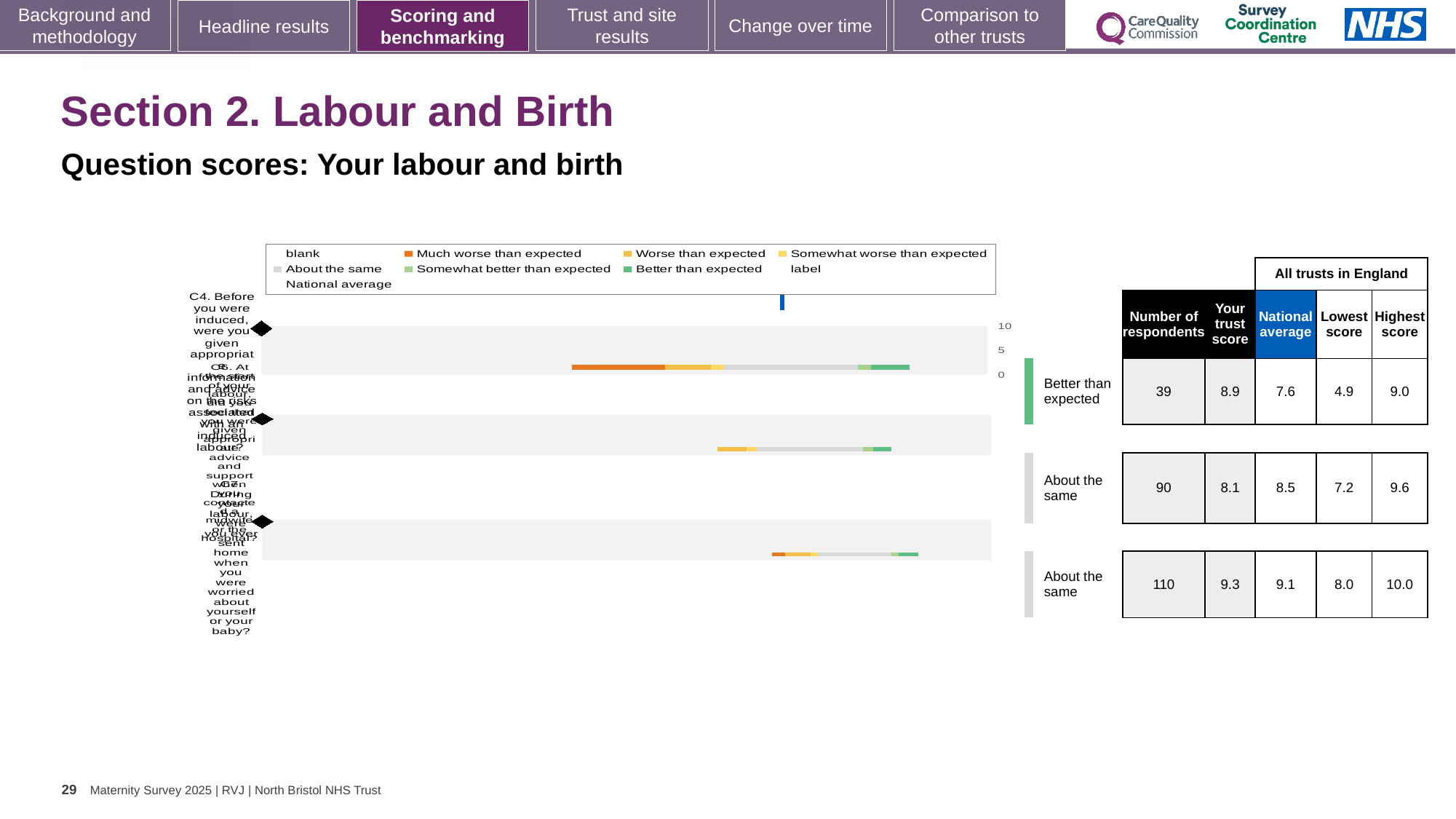
In the second row of the table, which is larger: the trust score or the national average? the national average What benchmark category is shown for the first row of the chart? Better than expected In the table beside the chart, what is the trust score for the second row? 8.1 In the chart legend, what colour represents 'Much worse than expected'? orange Which row in the table has the highest 'Highest score' value? the third row (10.0) In the table beside the chart, what is the national average for the third row? 9.1 Which row in the table has the lowest 'Lowest score' value? the first row (4.9) In the table beside the chart, what is the number of respondents for the first row? 39 In the chart legend, what colour represents 'Better than expected'? green In the first row of the table, what is the difference between the trust score and the national average? 1.3 What kind of chart is shown on the slide? horizontal stacked bar chart How many question rows (bars) are plotted in the chart? 3